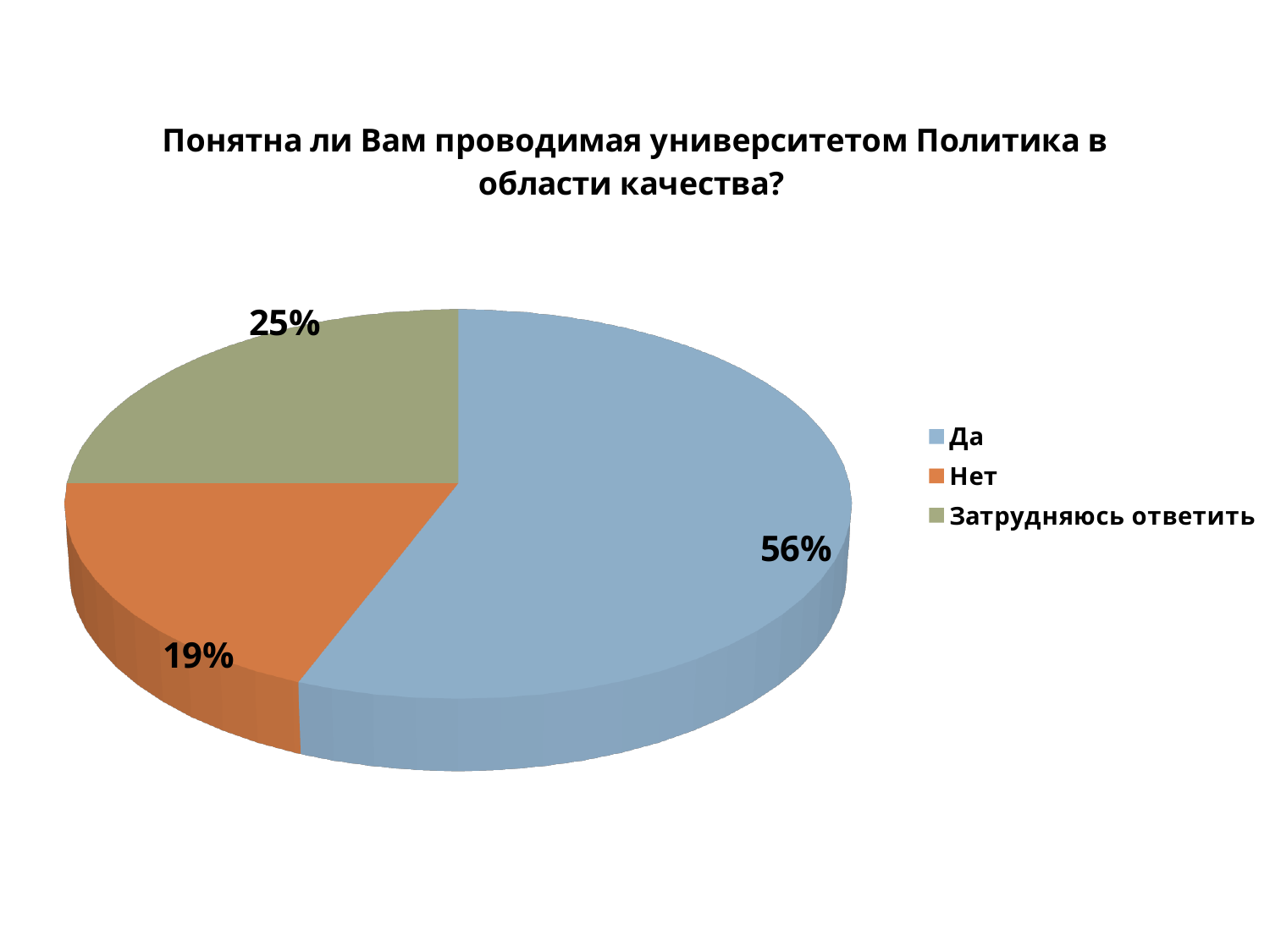
What type of chart is shown on the slide? Pie chart What share of the pie does "Нет" represent? 19% What is the difference in percentage points between the "Да" and "Нет" slices? 37 Which slice is larger, "Затрудняюсь ответить" or "Нет"? Затрудняюсь ответить What is the difference in percentage points between the "Затрудняюсь ответить" and "Нет" slices? 6 Which category has the largest slice of the pie? Да What colour is the "Нет" slice in the pie chart? Orange Which category has the smallest slice of the pie? Нет What share of the pie does "Затрудняюсь ответить" represent? 25% What is the title of the chart? Понятна ли Вам проводимая университетом Политика в области качества? What share of the pie does "Да" represent? 56% How many categories are shown in the pie chart? 3